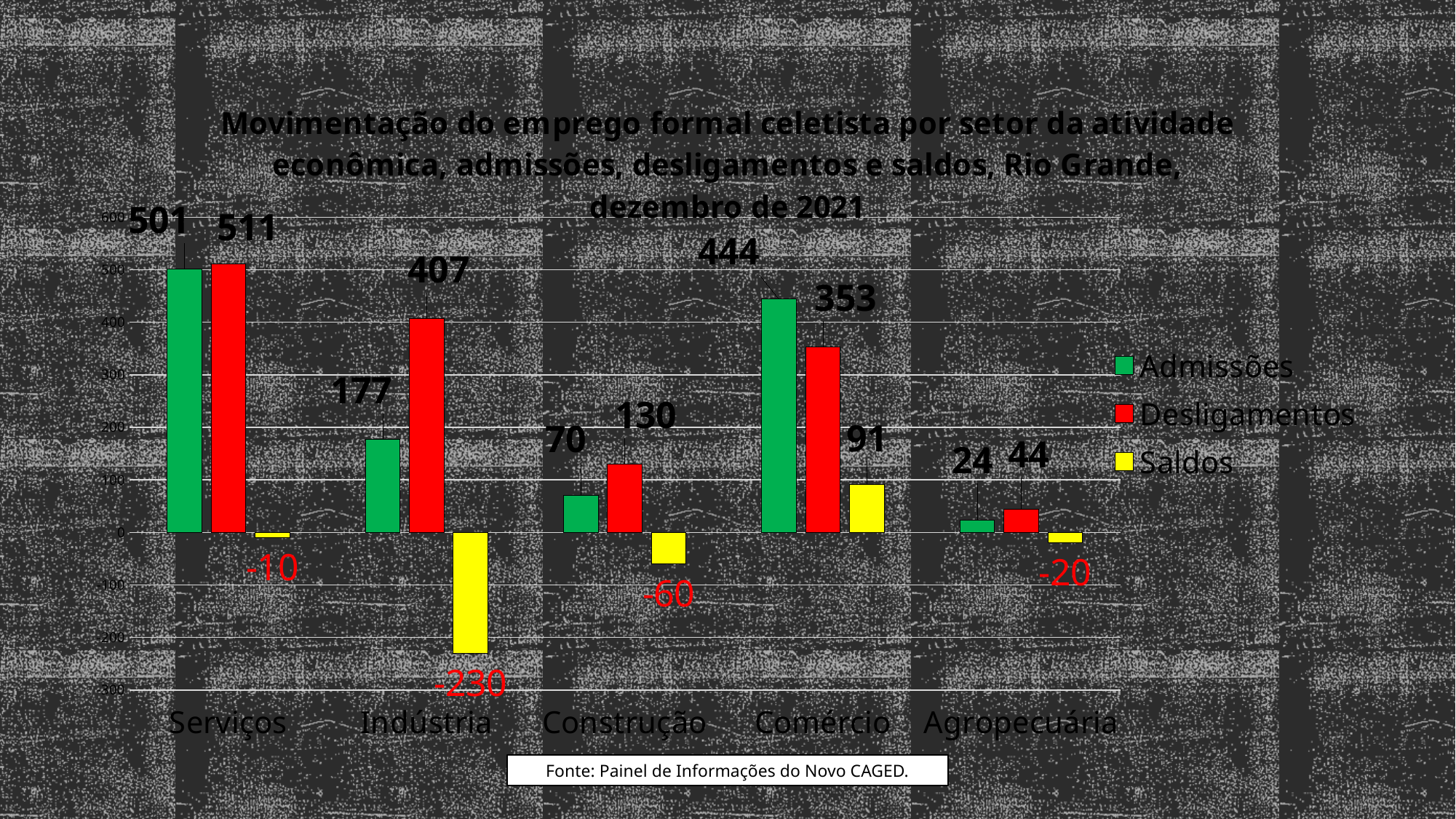
How many sectors are shown on the x axis? 5 Which sector has the lowest value for Desligamentos? Agropecuária Which is larger for Comércio, Admissões or Desligamentos? Admissões What is the value of Admissões for Serviços? 501 Which colour represents the Saldos series in the legend? Yellow What is the value of Saldos for Comércio? 91 Which sector has the highest value for Admissões? Serviços What is the value of Desligamentos for Indústria? 407 What kind of chart is shown on the slide? Bar chart What is the value of Saldos for Indústria? -230 What is the difference between Desligamentos and Admissões for Construção? 60 How many series does the legend list? 3